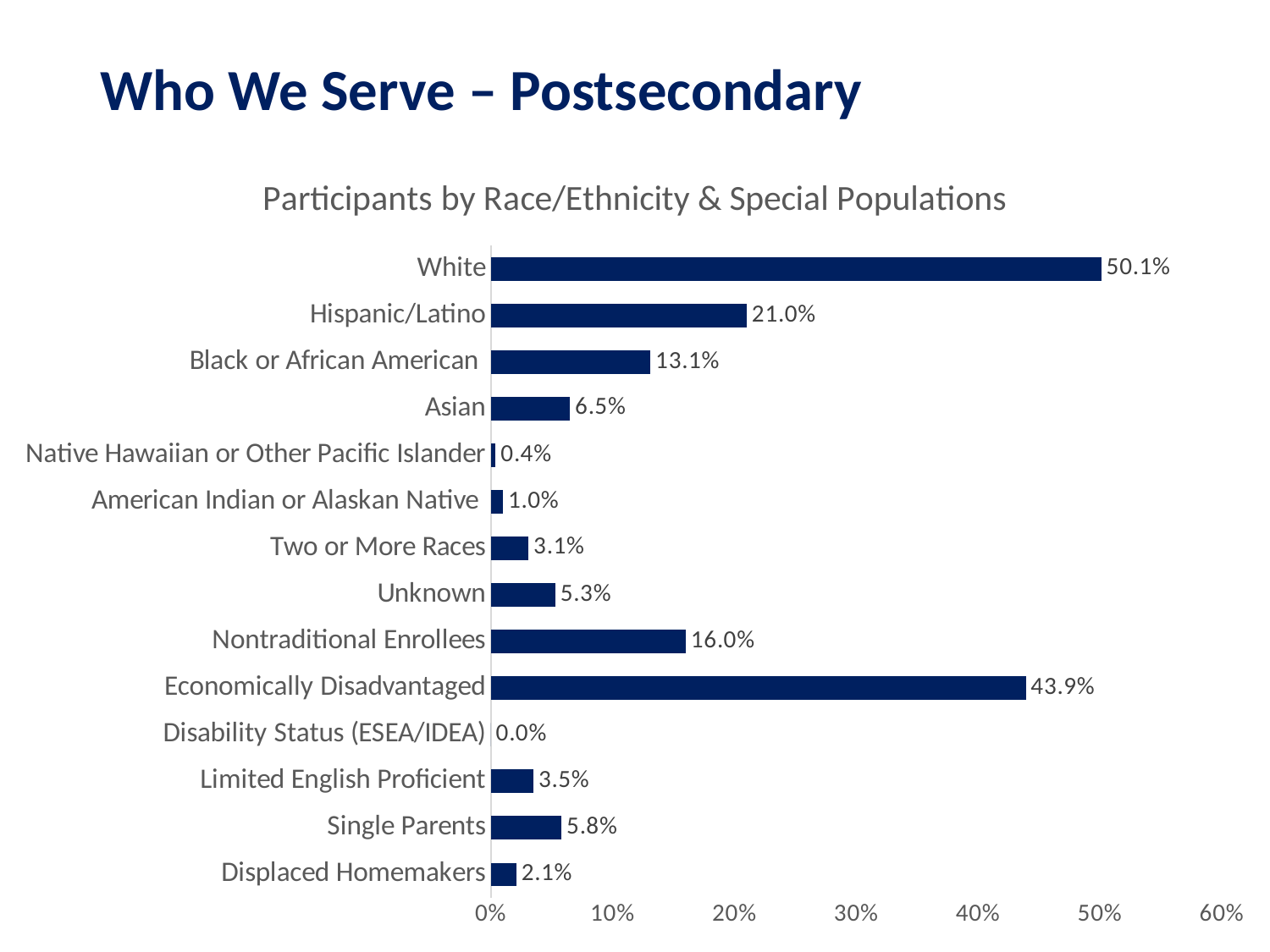
Is the value for Black or African American greater or less than 10%? greater What kind of chart is shown on the slide? Bar chart What is the difference between the values for White and Hispanic/Latino? 29.1% What is the value for White? 50.1% Which is larger, the value for Single Parents or the value for Asian? Asian Which category has the highest value? White What is the value for Native Hawaiian or Other Pacific Islander? 0.4% What is the value for Nontraditional Enrollees? 16.0% What is the value for Economically Disadvantaged? 43.9% What is the title of the chart? Participants by Race/Ethnicity & Special Populations Which category has the lowest value? Disability Status (ESEA/IDEA) How many categories are shown in the chart? 14